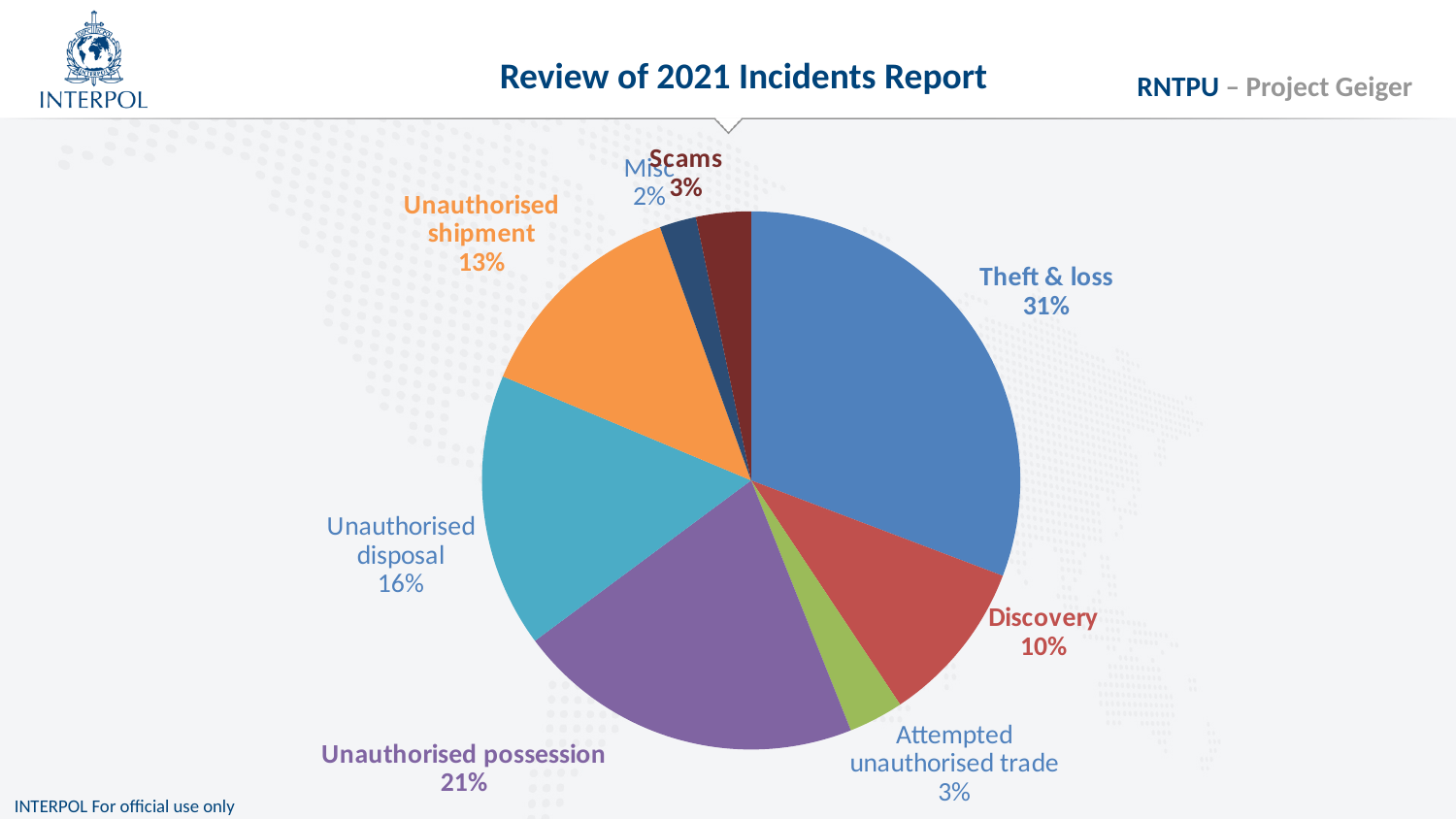
What share of incidents is attributed to Theft & loss? 31% What type of chart is shown on the slide? Pie chart How many categories are shown in the pie chart? 8 What percentage is shown for Unauthorised shipment? 13% What is the difference in percentage points between Theft & loss and Unauthorised possession? 10 Which is larger, Unauthorised disposal or Unauthorised shipment? Unauthorised disposal Which category has the smallest slice of the pie? Misc What percentage is shown for Misc? 2% What percentage is shown for Unauthorised disposal? 16% What percentage is shown for Discovery? 10% Which category has the largest slice of the pie? Theft & loss What percentage is shown for Unauthorised possession? 21%